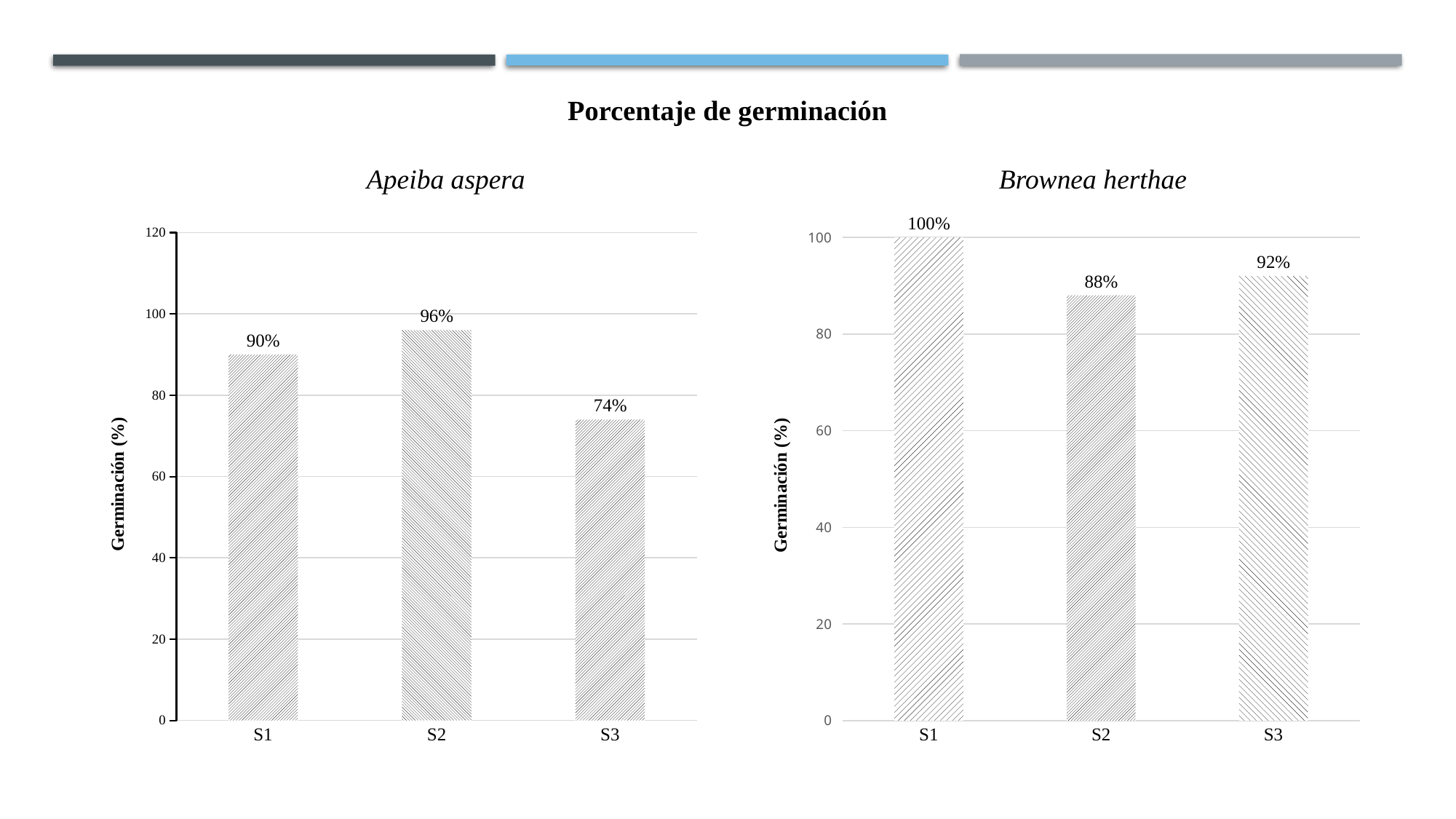
In the Brownea herthae chart, what is the germination value for S2? 88% In the Brownea herthae chart, what is the germination value for S3? 92% In the Brownea herthae chart, what is the difference between the S1 and S3 values? 8% In the Brownea herthae chart, which category has the lowest germination? S2 In the Apeiba aspera chart, what is the germination value for S3? 74% In the Apeiba aspera chart, what is the germination value for S1? 90% In the Apeiba aspera chart, which is larger, the value for S1 or the value for S3? S1 How many categories are shown in the Brownea herthae chart? 3 In the Apeiba aspera chart, what is the difference between the S2 and S3 values? 22% In the Apeiba aspera chart, which category has the highest germination? S2 What is the y-axis label of the Brownea herthae chart? Germinación (%) What kind of chart is the Apeiba aspera chart? Bar chart